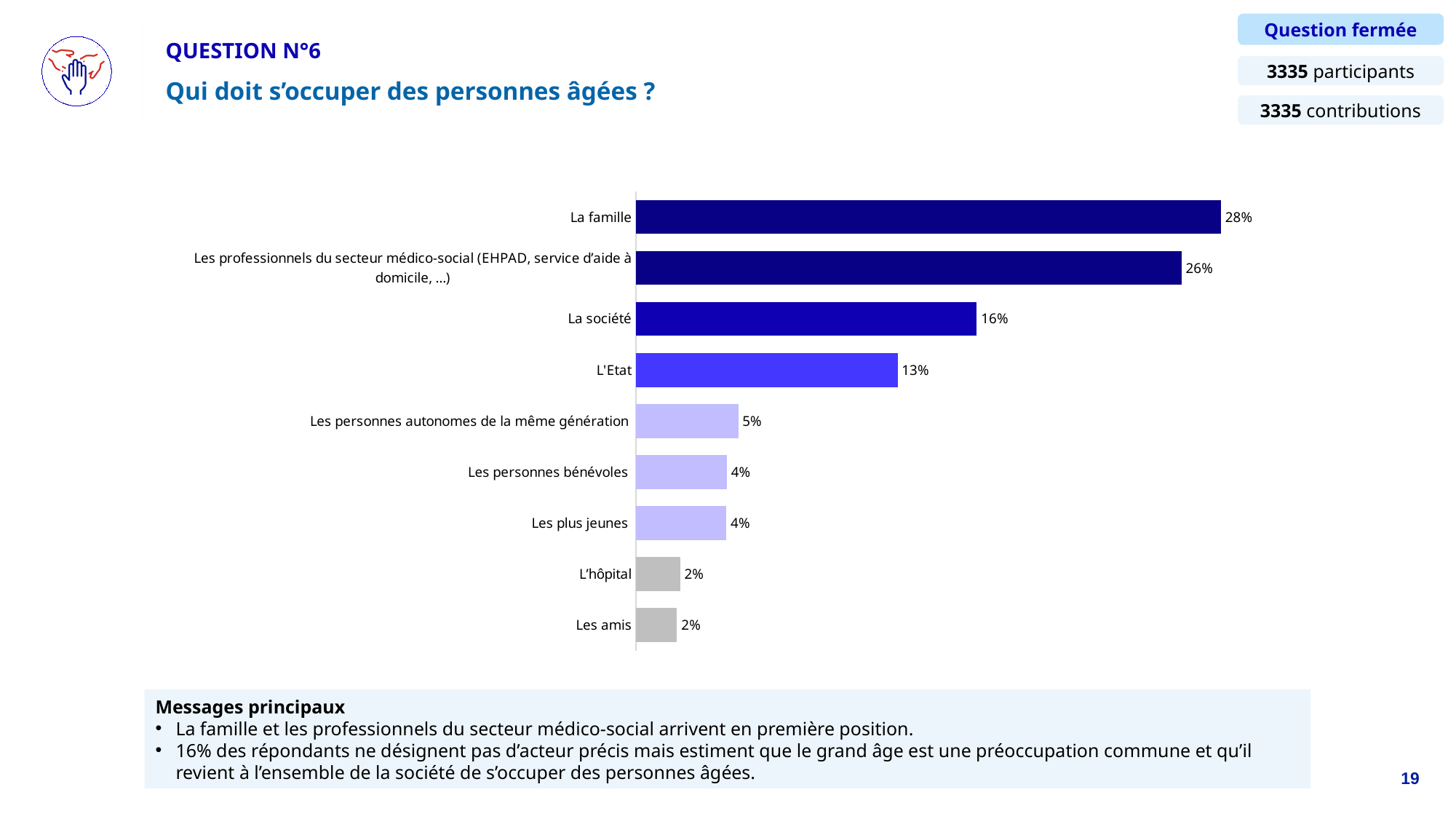
What is the value for La société? 16% Which category has the highest value? La famille Which is larger, the value for La société or the value for Les personnes autonomes de la même génération? La société How many participants are indicated on the slide? 3335 What is the value for Les personnes bénévoles? 4% What is the value for La famille? 28% What is the value for Les professionnels du secteur médico-social (EHPAD, service d'aide à domicile, ...)? 26% How many categories are shown in the chart? 9 What kind of chart is shown on the slide? Bar chart What is the value for L'Etat? 13% What is the difference between La famille and Les professionnels du secteur médico-social (EHPAD, service d'aide à domicile, ...)? 2% What is the difference between La société and L'Etat? 3%